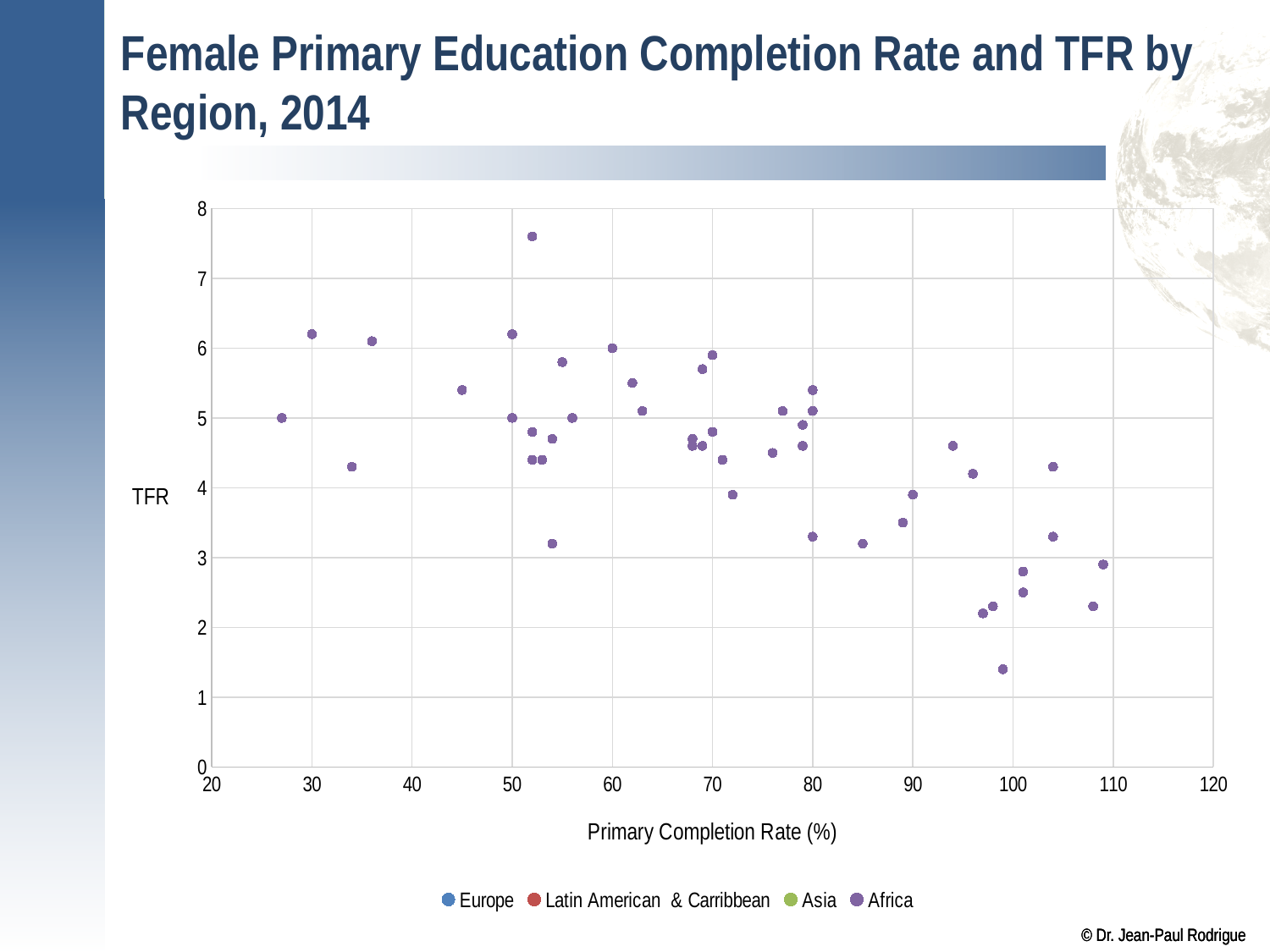
Is the TFR of the highest point on the chart greater or less than 7? greater Is the TFR of the point with the highest primary completion rate (around 109%) greater or less than 4? less As the primary completion rate increases along the x axis, does TFR generally rise or fall? fall Is the primary completion rate of the point with the lowest TFR greater or less than 90? greater Which has the higher TFR: the point at a primary completion rate of about 30% or the point at about 99%? the point at about 30% What is the label of the x axis? Primary Completion Rate (%) How many series does the legend list? 4 What is the title of the chart? Female Primary Education Completion Rate and TFR by Region, 2014 What kind of chart is shown on the slide? scatter chart